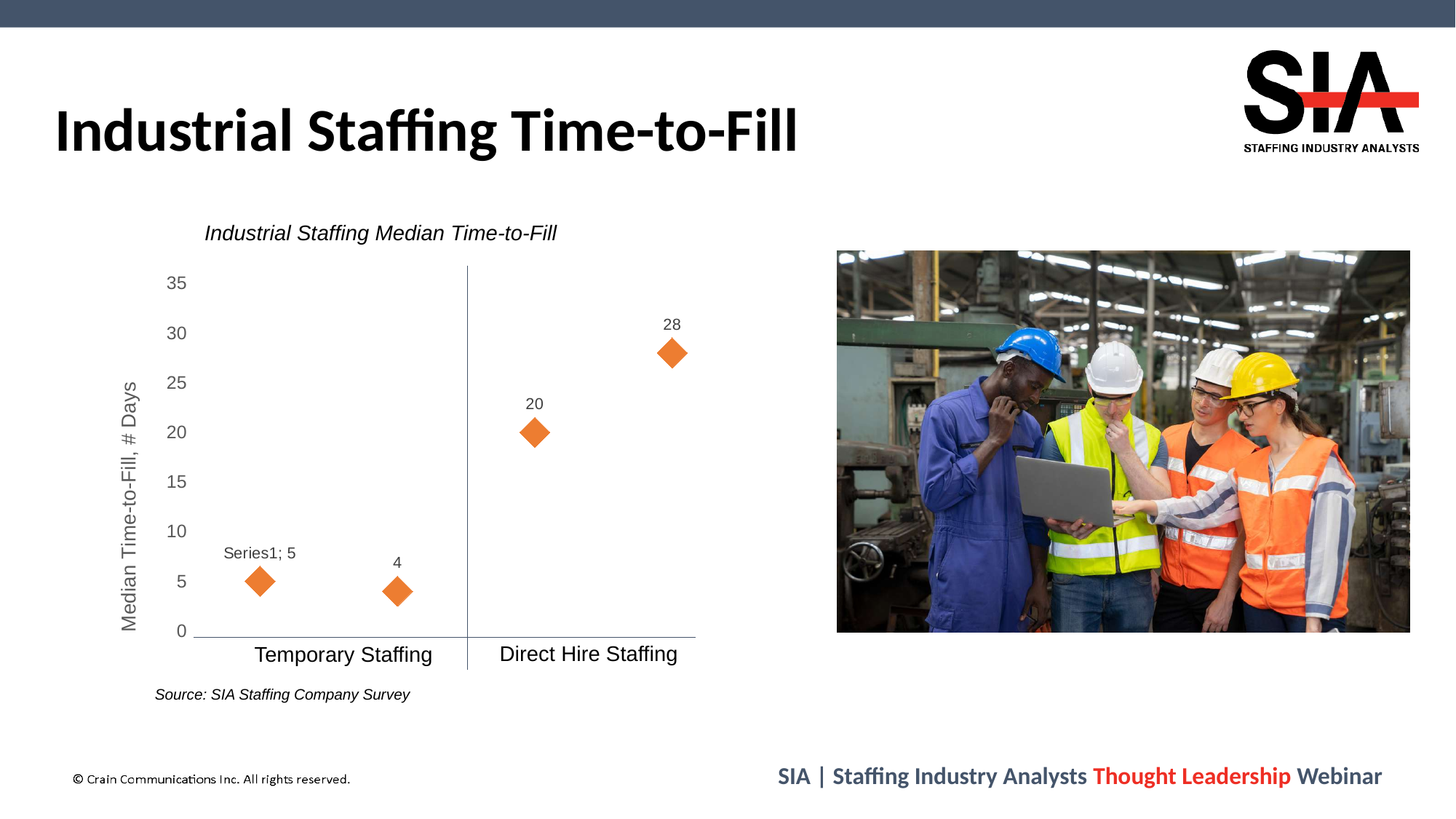
What is the difference between the two values plotted under Direct Hire Staffing? 8 What is the source cited below the chart? SIA Staffing Company Survey What is the value of the point labelled 'Series1'? 5 How many data points are plotted on the chart? 4 What is the lowest value plotted on the chart? 4 What is the title of the chart? Industrial Staffing Median Time-to-Fill What is the highest value plotted on the chart? 28 Is the highest value under Direct Hire Staffing greater or less than 25? greater What is the difference between the highest value (28) and the lowest value (4) on the chart? 24 What are the two category groups shown on the x axis? Temporary Staffing and Direct Hire Staffing Which category group has the higher values, Temporary Staffing or Direct Hire Staffing? Direct Hire Staffing